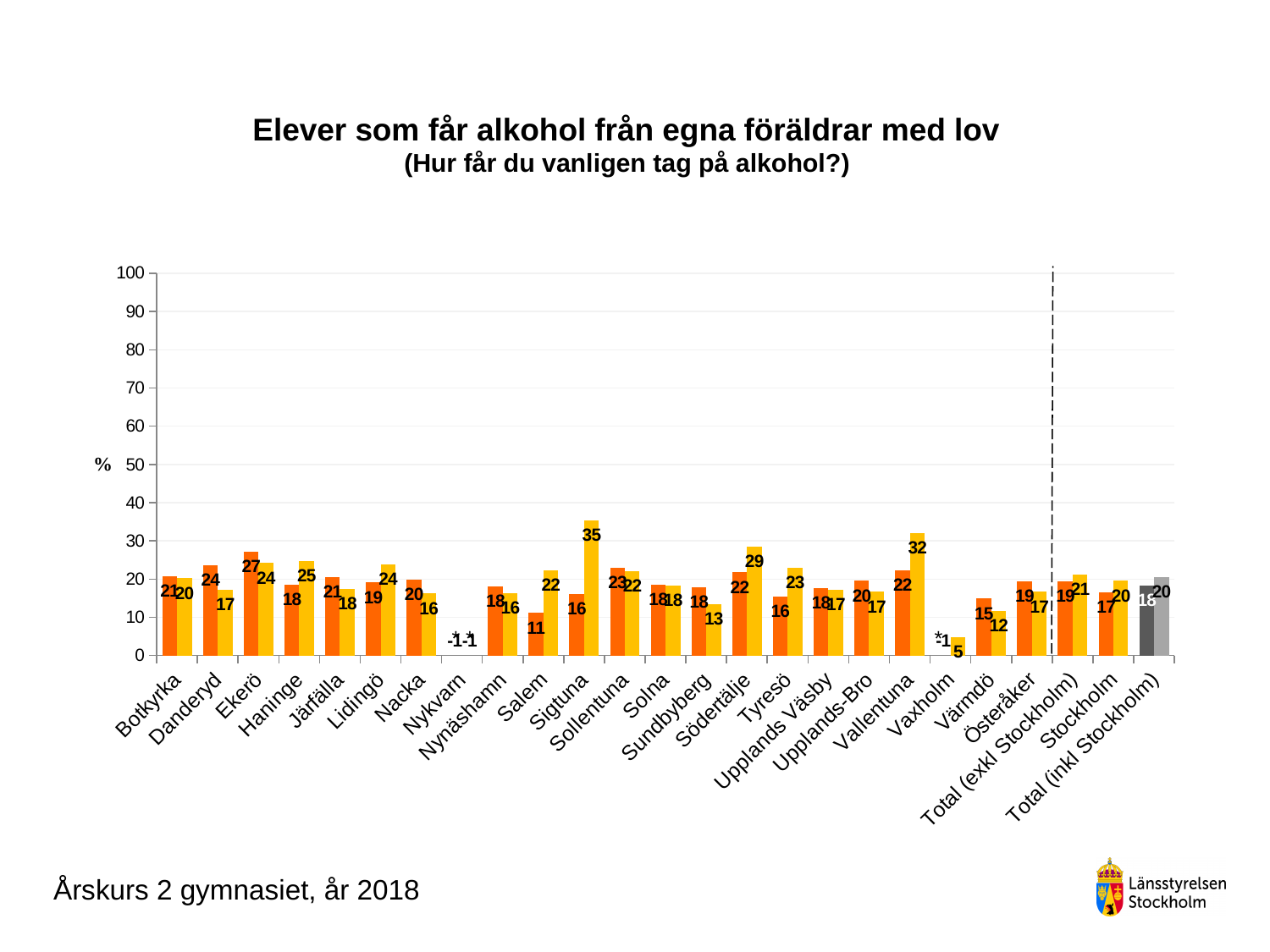
What is the value of the yellow (second) bar for Sigtuna? 35 Which category has the highest yellow (second) bar? Sigtuna Which category has the highest orange (first) bar? Ekerö What is the title of the chart? Elever som får alkohol från egna föräldrar med lov What is the value of the orange (first) bar for Ekerö? 27 What is the value of the yellow (second) bar for Vallentuna? 32 How many categories are shown on the x axis? 25 Which is larger for Danderyd, the orange (first) bar or the yellow (second) bar? the orange (first) bar Is the value of the yellow (second) bar for Södertälje greater or less than 20? greater What is the difference between the yellow bar and the orange bar for Sigtuna? 19 What kind of chart is shown on the slide? bar chart What is the value of the orange (first) bar for Salem? 11